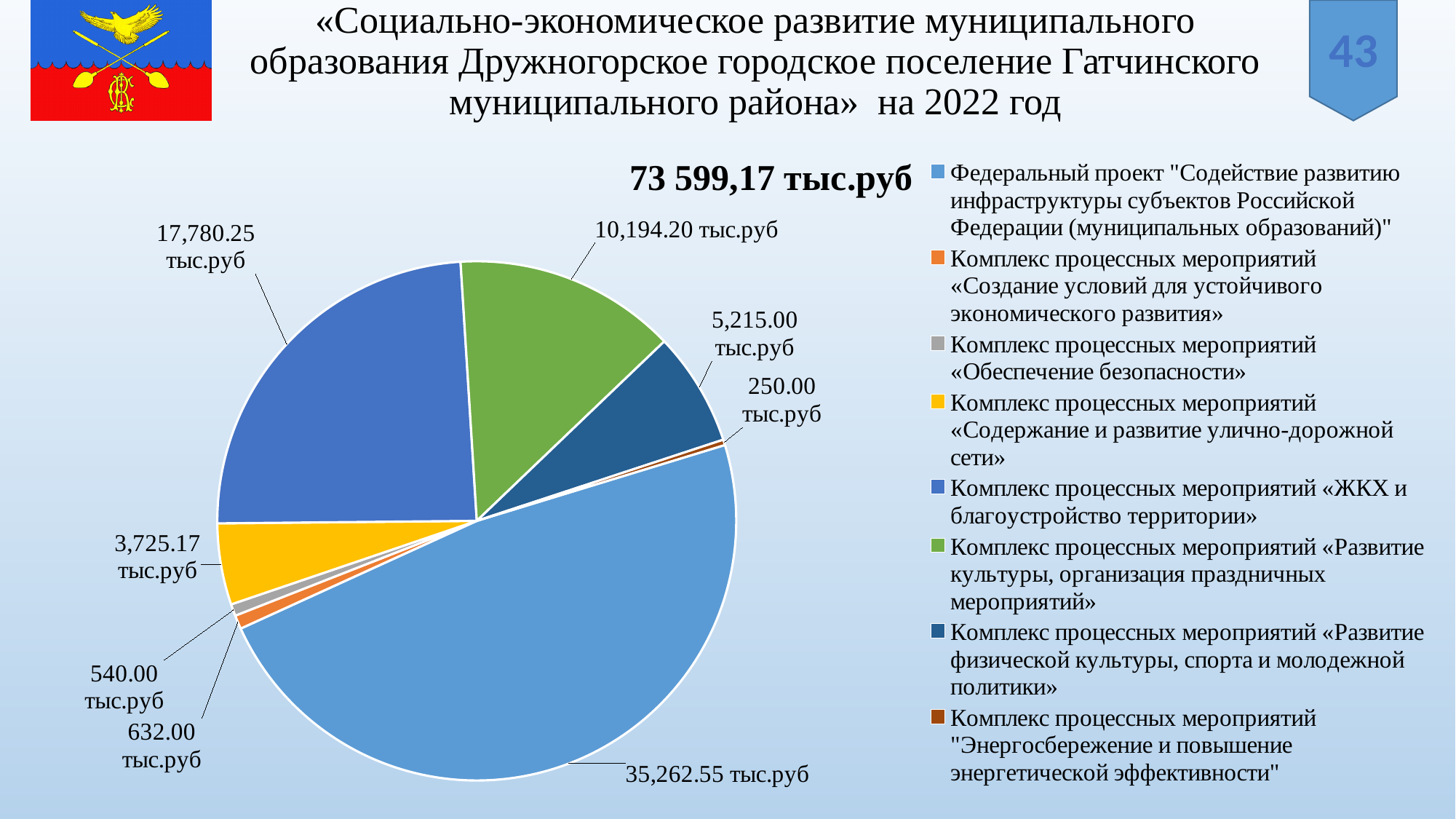
Which category has the largest slice of the pie? Федеральный проект "Содействие развитию инфраструктуры субъектов Российской Федерации (муниципальных образований)" How many entries does the legend list? 8 What is the value for the «Развитие культуры, организация праздничных мероприятий» slice? 10,194.20 тыс.руб What is the value for the «ЖКХ и благоустройство территории» slice? 17,780.25 тыс.руб Which category has the smallest slice of the pie? Комплекс процессных мероприятий "Энергосбережение и повышение энергетической эффективности" What is the value for the Федеральный проект "Содействие развитию инфраструктуры субъектов Российской Федерации (муниципальных образований)" slice? 35,262.55 тыс.руб What is the value for the «Содержание и развитие улично-дорожной сети» slice? 3,725.17 тыс.руб What total amount is shown above the pie chart? 73 599,17 тыс.руб What is the difference between the «ЖКХ и благоустройство территории» value and the «Развитие культуры, организация праздничных мероприятий» value? 7,586.05 тыс.руб What is the value for the «Энергосбережение и повышение энергетической эффективности» slice? 250.00 тыс.руб How many slices does the pie chart have? 8 What type of chart is shown on the slide? Pie chart